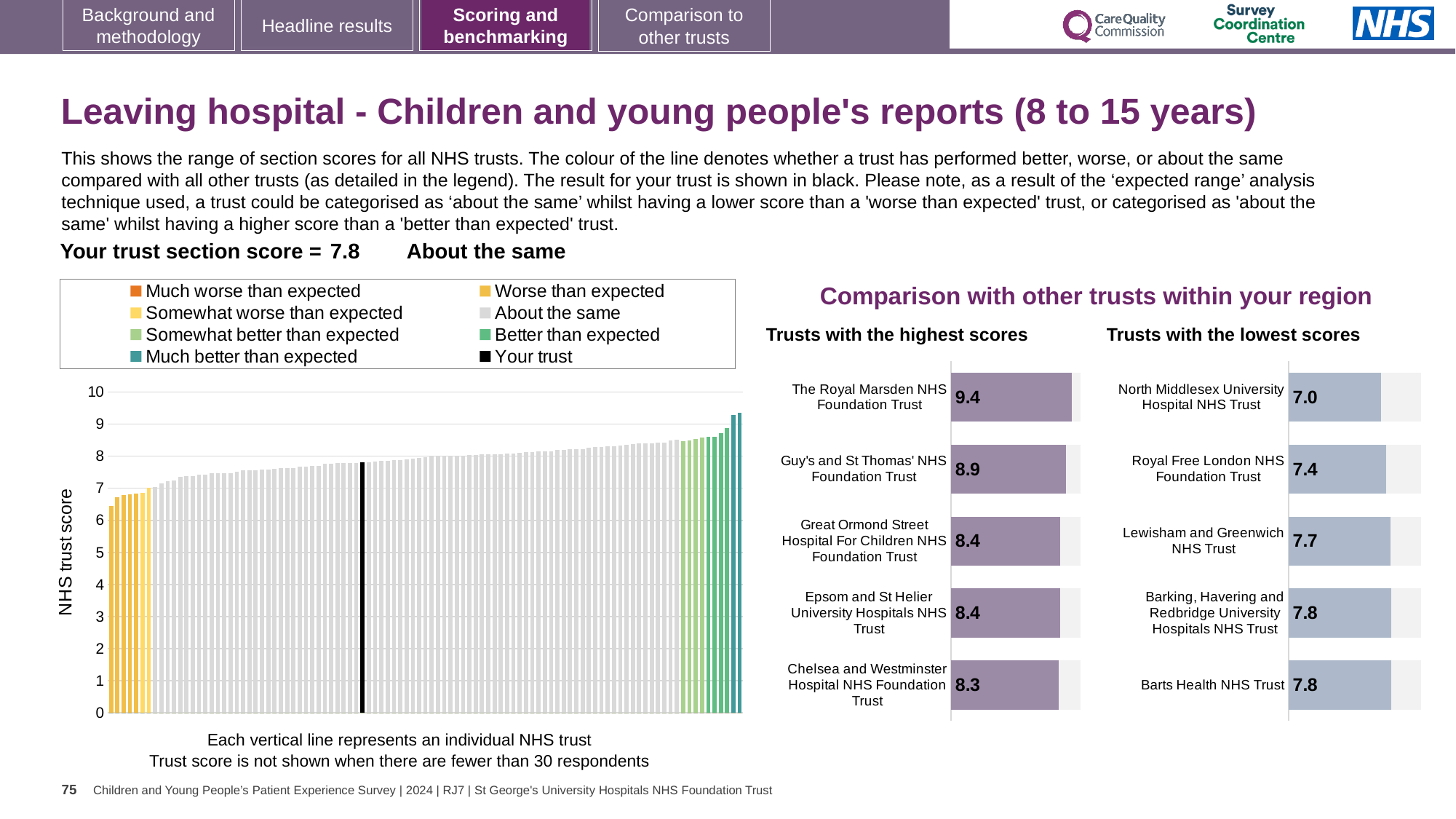
In the 'Trusts with the highest scores' chart, what is the score for The Royal Marsden NHS Foundation Trust? 9.4 What type of chart is the large chart on the left showing NHS trust scores? Bar chart In the large chart on the left, is the value for the black 'Your trust' bar greater or less than 8? less How many trusts are shown in the 'Trusts with the lowest scores' chart? 5 How many entries does the legend of the large chart on the left list? 8 In the 'Trusts with the highest scores' chart, which trust has the highest score? The Royal Marsden NHS Foundation Trust In the 'Trusts with the highest scores' chart, what is the difference between the scores of The Royal Marsden NHS Foundation Trust and Chelsea and Westminster Hospital NHS Foundation Trust? 1.1 In the 'Trusts with the lowest scores' chart, what is the score for North Middlesex University Hospital NHS Trust? 7.0 In the 'Trusts with the highest scores' chart, which has the larger score: Guy's and St Thomas' NHS Foundation Trust or Great Ormond Street Hospital For Children NHS Foundation Trust? Guy's and St Thomas' NHS Foundation Trust In the 'Trusts with the lowest scores' chart, which trust has the lowest score? North Middlesex University Hospital NHS Trust In the 'Trusts with the highest scores' chart, what is the score for Chelsea and Westminster Hospital NHS Foundation Trust? 8.3 In the 'Trusts with the lowest scores' chart, what is the difference between the scores of Barts Health NHS Trust and North Middlesex University Hospital NHS Trust? 0.8